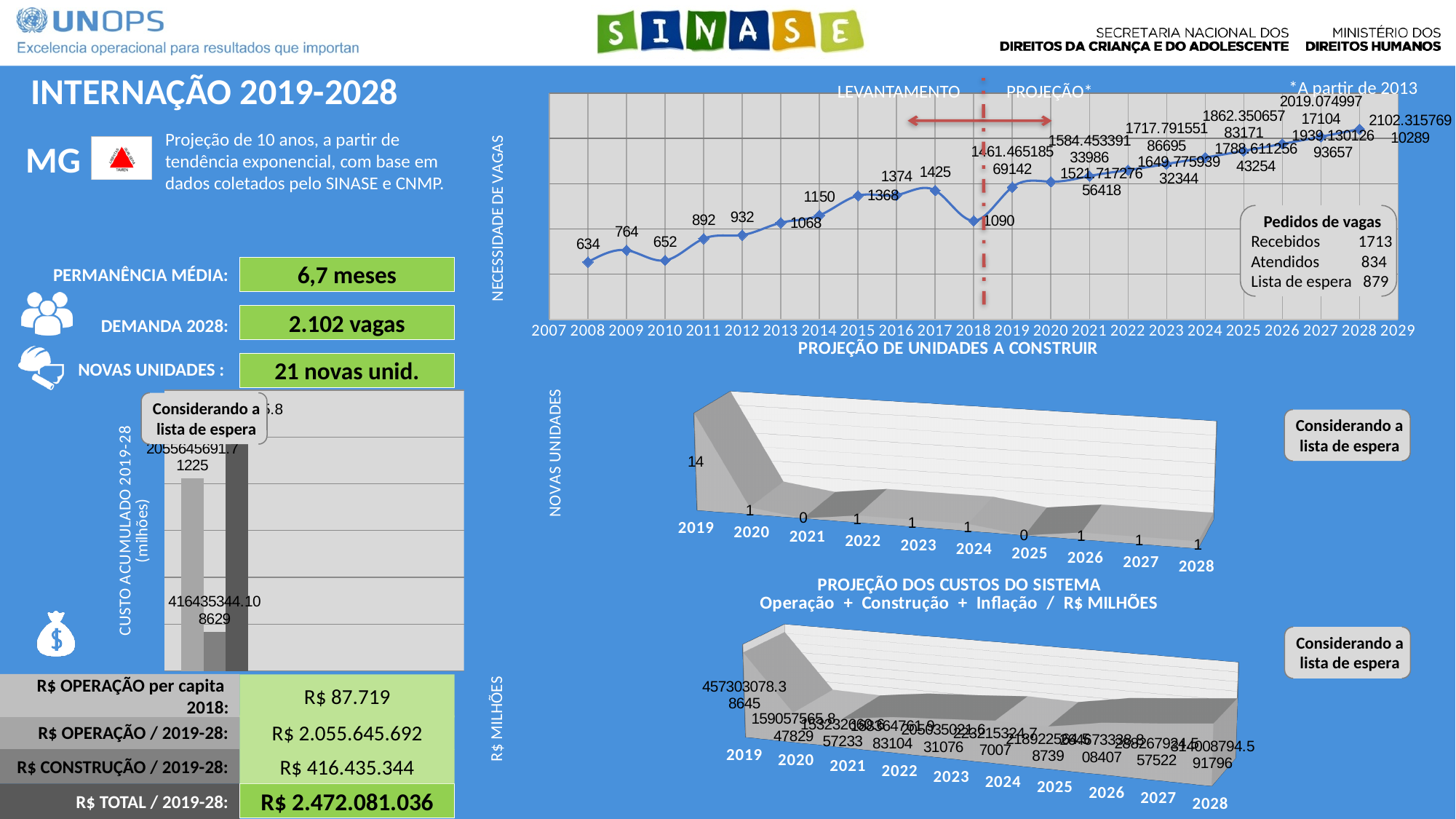
In the PROJEÇÃO DE UNIDADES A CONSTRUIR chart, what is the value for 2021? 0 In the NECESSIDADE DE VAGAS chart, which year has the larger value, 2013 or 2014? 2014 In the NECESSIDADE DE VAGAS chart, what is the value for 2008? 634 In the NECESSIDADE DE VAGAS chart, what is the value for 2017? 1425 In the NECESSIDADE DE VAGAS chart, what is the value for 2018? 1090 What kind of chart is the top chart labelled NECESSIDADE DE VAGAS? line chart In the NECESSIDADE DE VAGAS chart, which year has the lowest value? 2008 In the NECESSIDADE DE VAGAS chart, do the values generally rise or fall from 2008 to 2017? rise In the PROJEÇÃO DE UNIDADES A CONSTRUIR chart, what is the value for 2019? 14 In the NECESSIDADE DE VAGAS chart, what is the difference between the 2017 and 2018 values? 335 In the PROJEÇÃO DE UNIDADES A CONSTRUIR chart, which year has the highest value? 2019 How many years are shown on the x axis of the PROJEÇÃO DE UNIDADES A CONSTRUIR chart? 10